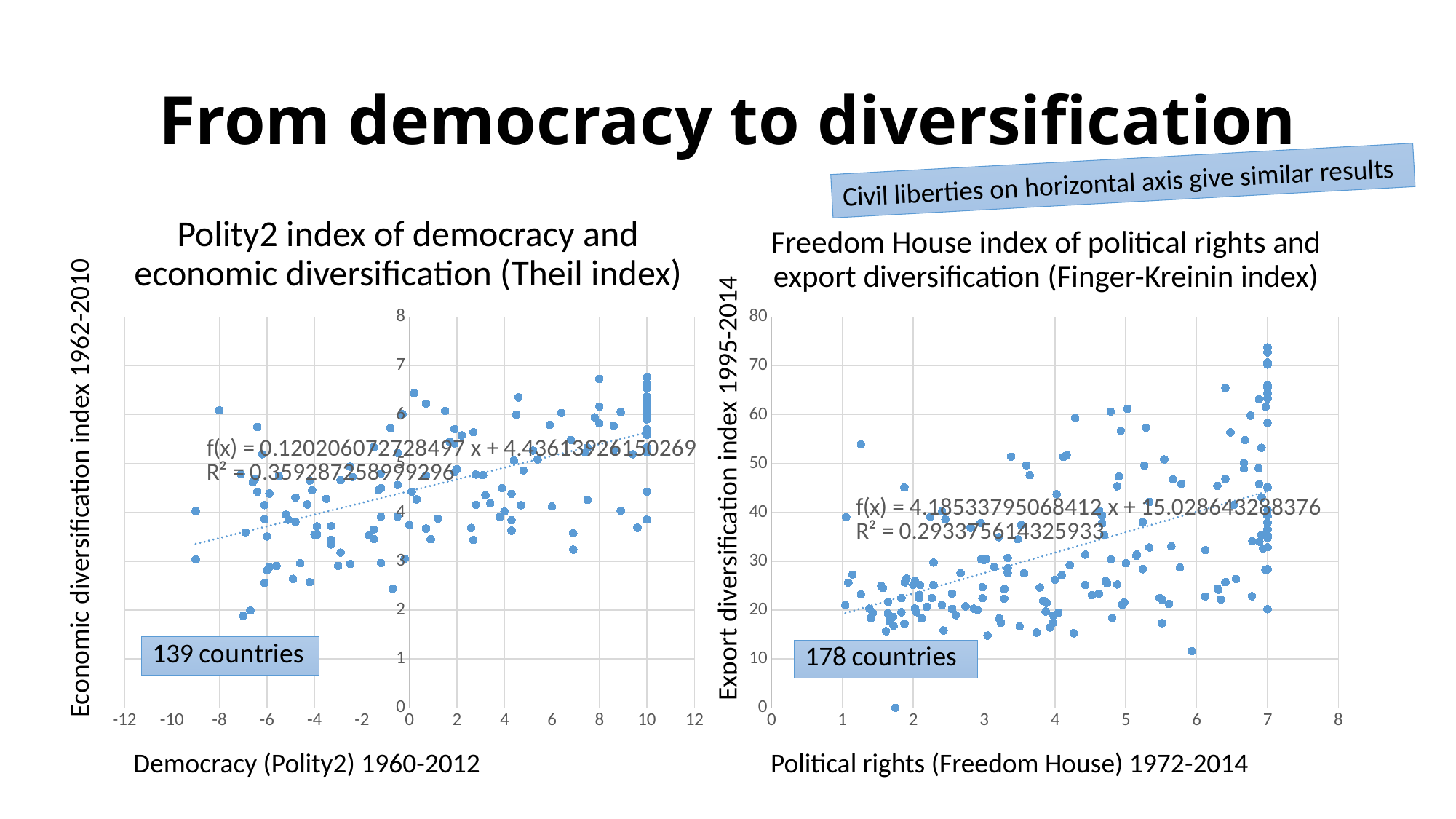
What kind of chart is the right chart, titled 'Freedom House index of political rights and export diversification (Finger-Kreinin index)'? scatter chart In the left chart (Polity2 index of democracy and economic diversification), does the fitted trend line rise or fall as the democracy score increases along the x axis? rise What is the x-axis label of the left chart (Polity2 index of democracy and economic diversification)? Democracy (Polity2) 1960-2012 What kind of chart is the left chart, titled 'Polity2 index of democracy and economic diversification (Theil index)'? scatter chart Which chart has the higher R² value, the left chart (Polity2) or the right chart (Freedom House)? the left chart (Polity2) What is the slope of the fitted line f(x) shown on the right chart (Freedom House index of political rights and export diversification)? 4.18533795068412 How many countries are plotted in the right chart (Freedom House index of political rights and export diversification)? 178 countries What is the R² value shown on the left chart (Polity2 index of democracy and economic diversification)? 0.359287258999296 How many countries are plotted in the left chart (Polity2 index of democracy and economic diversification)? 139 countries What is the R² value shown on the right chart (Freedom House index of political rights and export diversification)? 0.293375614325933 In the right chart (Freedom House index of political rights and export diversification), does the fitted trend line rise or fall as political rights increase along the x axis? rise In the right chart (Freedom House index of political rights and export diversification), is the highest plotted export diversification value greater or less than 70? greater